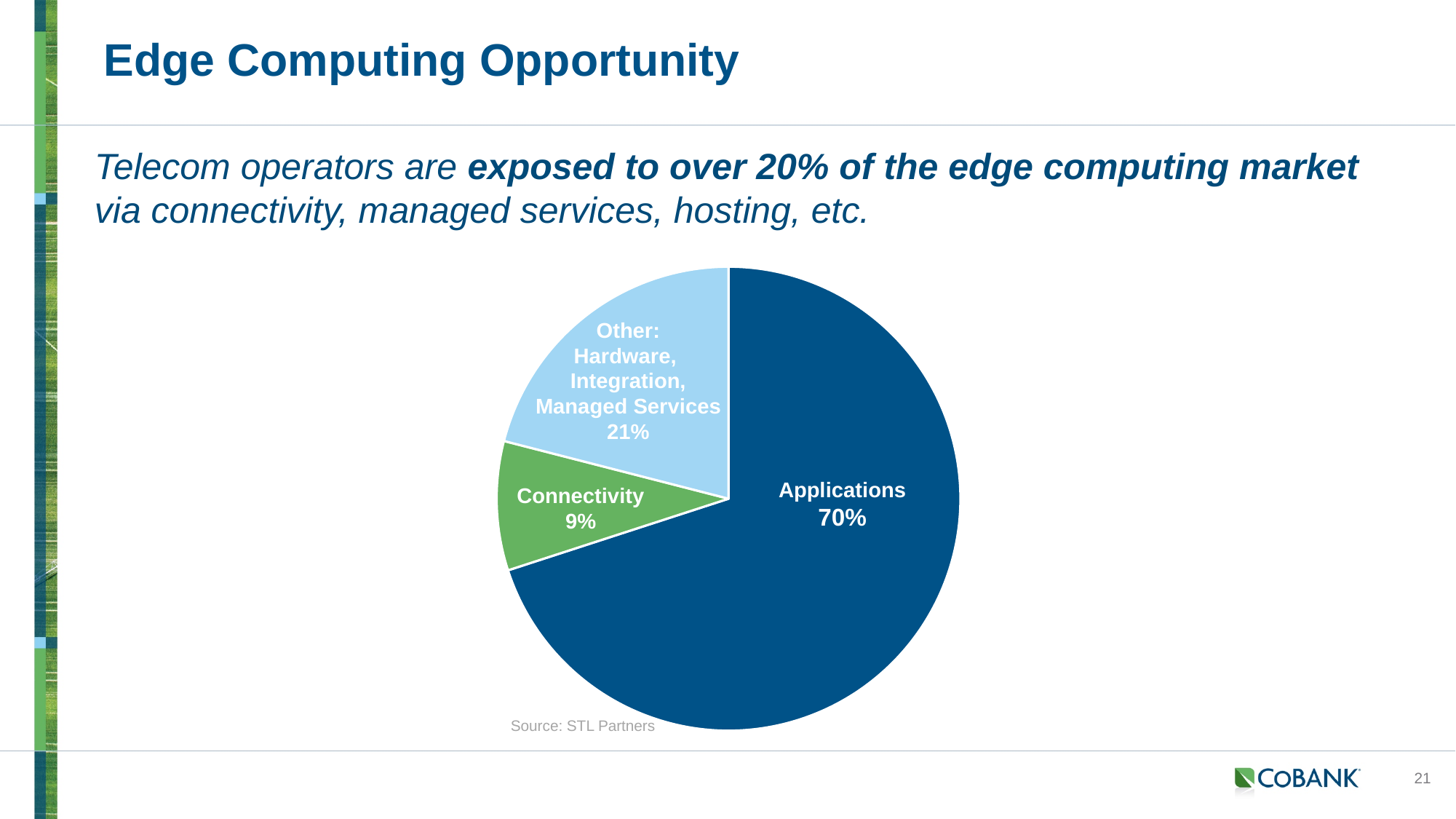
What is the difference in percentage points between the Applications slice and the Other slice? 49 Which is larger, the Connectivity slice or the Other: Hardware, Integration, Managed Services slice? Other: Hardware, Integration, Managed Services Which slice of the pie is the smallest? Connectivity Which slice of the pie is the largest? Applications What colour is the Connectivity slice? Green What is the combined share of the Connectivity and Other slices? 30% What share of the pie does Connectivity account for? 9% What share of the pie does Applications account for? 70% How many slices does the pie chart have? 3 What share of the pie does the Other: Hardware, Integration, Managed Services slice account for? 21% What kind of chart is shown on the slide? Pie chart What is the difference in percentage points between the Other slice and the Connectivity slice? 12